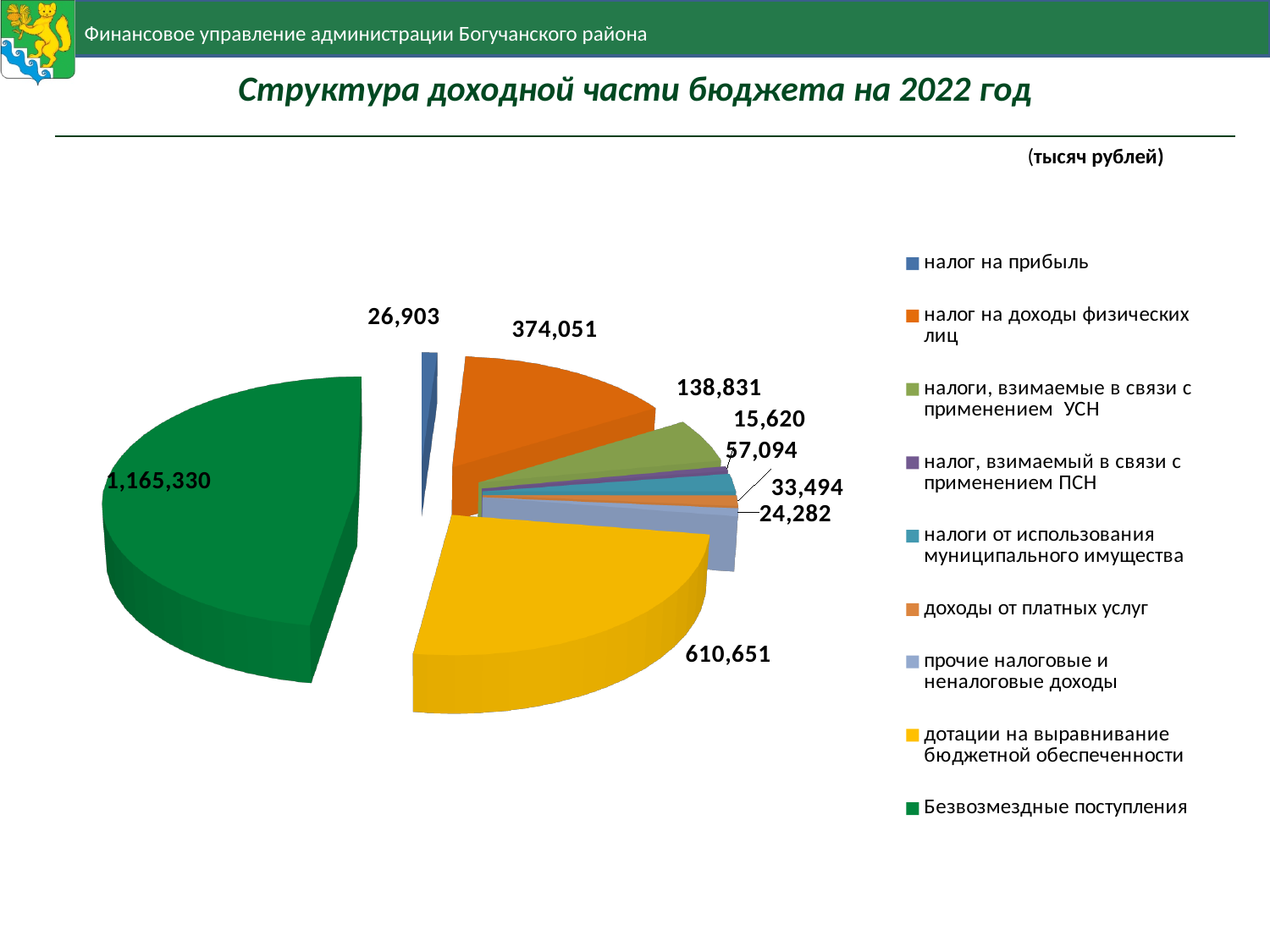
What is the value for налог на доходы физических лиц? 374,051 What is the value for налог на прибыль? 26,903 Which category has the smallest slice in the pie chart? налог, взимаемый в связи с применением ПСН What is the value for Безвозмездные поступления? 1,165,330 What is the value for налоги от использования муниципального имущества? 57,094 Which is larger: налог на доходы физических лиц or налоги, взимаемые в связи с применением УСН? налог на доходы физических лиц What is the value for налоги, взимаемые в связи с применением УСН? 138,831 Which category has the largest slice in the pie chart? Безвозмездные поступления What type of chart is shown on the slide? pie chart What is the difference between Безвозмездные поступления and дотации на выравнивание бюджетной обеспеченности? 554,679 What is the value for дотации на выравнивание бюджетной обеспеченности? 610,651 How many categories does the legend of the pie chart list? 9